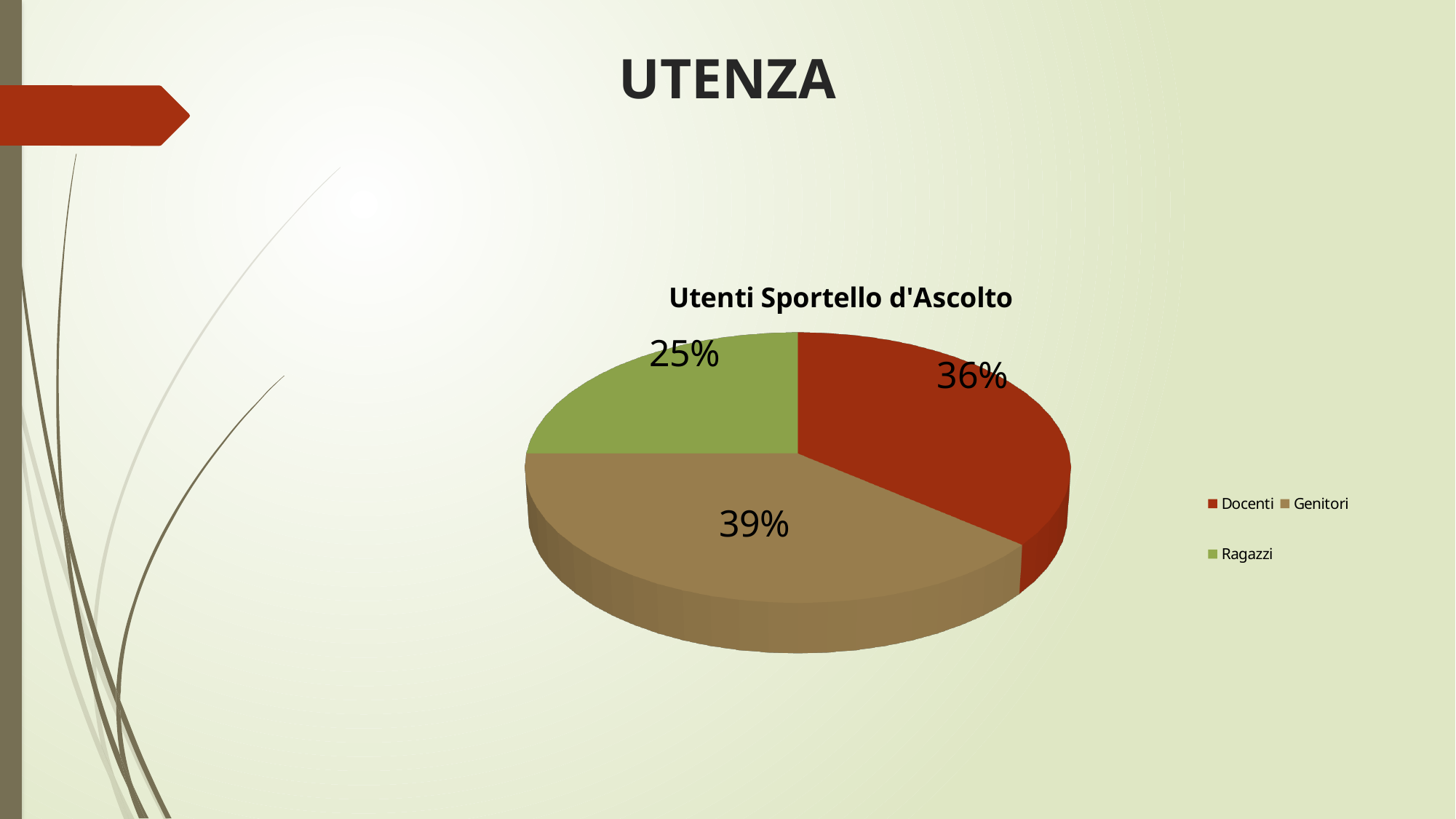
Which is larger, the Docenti slice or the Ragazzi slice? Docenti How many categories are shown in the pie chart? 3 Which category has the smallest slice of the pie? Ragazzi Which category has the largest slice of the pie? Genitori What is the difference in percentage points between Genitori and Ragazzi? 14 What is the difference in percentage points between Docenti and Ragazzi? 11 What is the title of the chart? Utenti Sportello d'Ascolto What kind of chart is shown on the slide? Pie chart What share of the pie does Docenti represent? 36% Which colour represents Ragazzi in the chart? Green What share of the pie does Ragazzi represent? 25% What share of the pie does Genitori represent? 39%